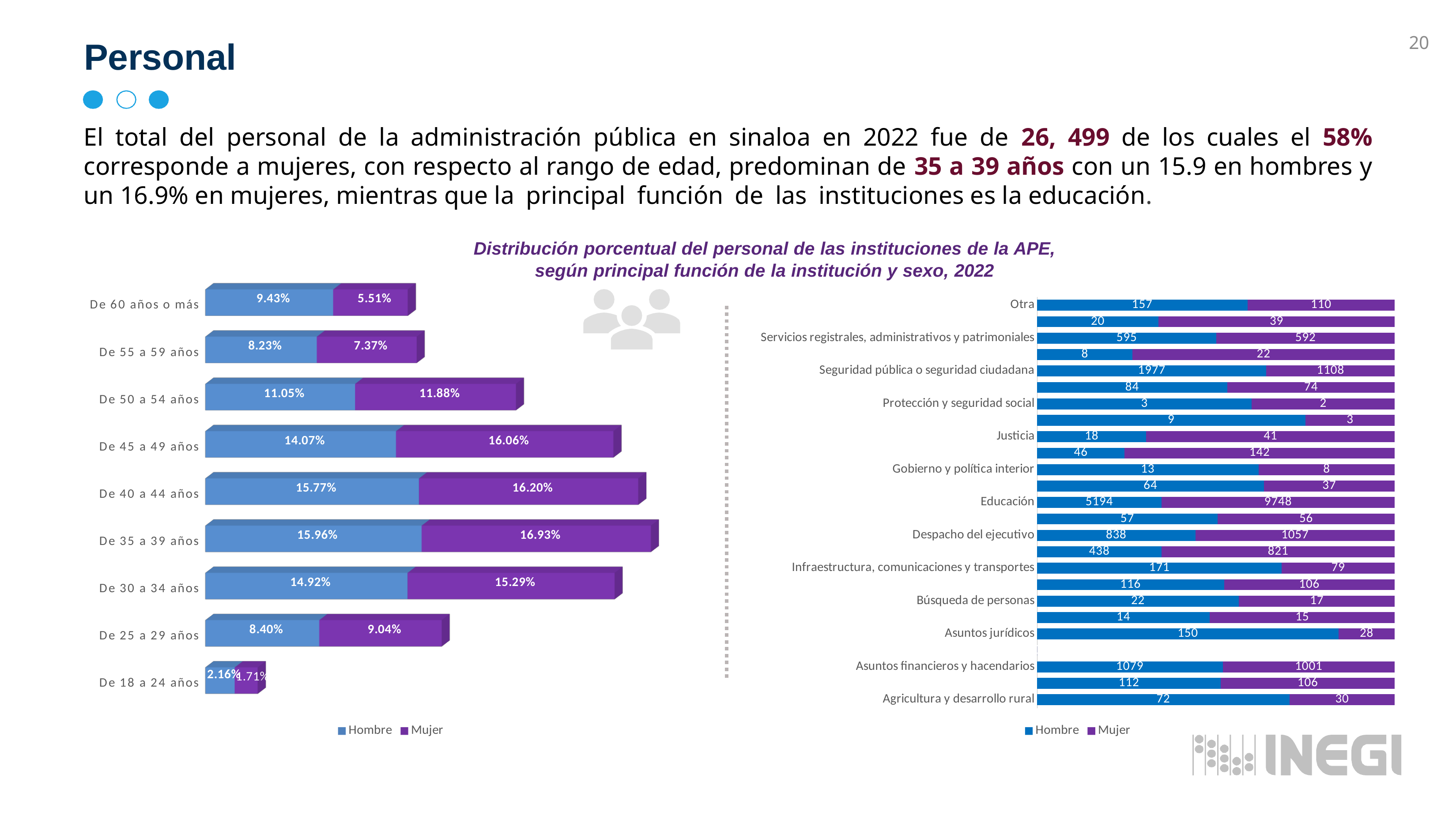
In the left chart of age ranges, what type of chart is it? bar chart In the left chart of age ranges, which age range has the lowest Hombre value? De 18 a 24 años In the left chart of age ranges, how many age ranges are shown? 9 In the chart titled 'Distribución porcentual del personal de las instituciones de la APE, según principal función de la institución y sexo, 2022', what is the total of Hombre and Mujer for Agricultura y desarrollo rural? 102 In the chart titled 'Distribución porcentual del personal de las instituciones de la APE, según principal función de la institución y sexo, 2022', which is larger for Despacho del ejecutivo, Hombre or Mujer? Mujer In the left chart of age ranges, which age range has the highest Mujer value? De 35 a 39 años In the left chart of age ranges, what is the Hombre value for De 35 a 39 años? 15.96% In the left chart of age ranges, what is the difference between the Mujer and Hombre values for De 45 a 49 años? 1.99% In the left chart of age ranges, what is the Mujer value for De 60 años o más? 5.51% In the chart titled 'Distribución porcentual del personal de las instituciones de la APE, según principal función de la institución y sexo, 2022', what is the Hombre value for Seguridad pública o seguridad ciudadana? 1977 In the chart titled 'Distribución porcentual del personal de las instituciones de la APE, según principal función de la institución y sexo, 2022', what is the Mujer value for Educación? 9748 In the chart titled 'Distribución porcentual del personal de las instituciones de la APE, según principal función de la institución y sexo, 2022', how many series does the legend list? 2